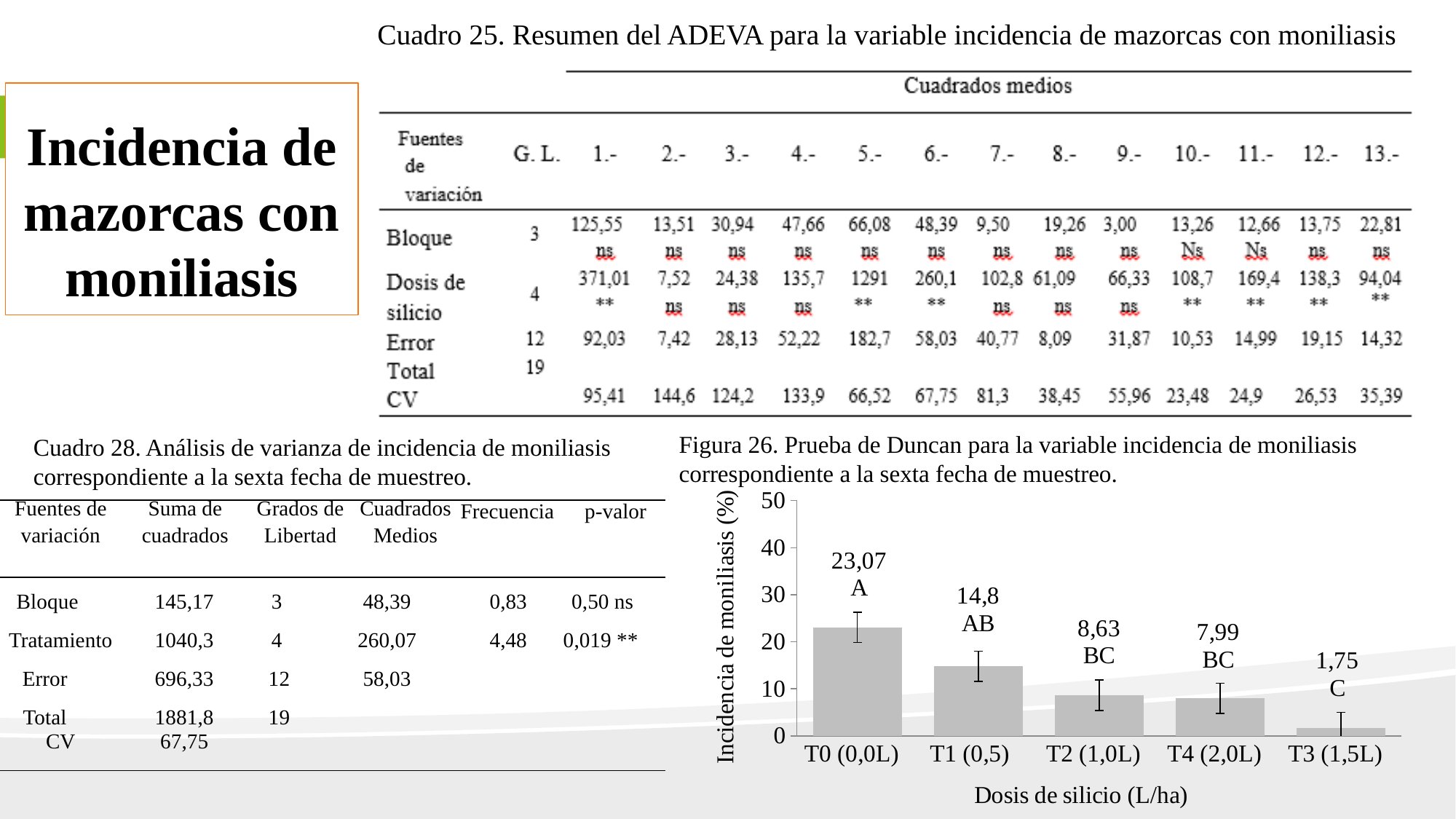
Which dose has the highest incidence of moniliasis in the Figura 26 bar chart? T0 (0,0L) In the Figura 26 bar chart, what is the difference between the values for T0 (0,0L) and T1 (0,5)? 8,27 Which dose has the lowest incidence of moniliasis in the Figura 26 bar chart? T3 (1,5L) What is the y-axis label of the Figura 26 bar chart? Incidencia de moniliasis (%) How many bars are shown in the Figura 26 bar chart? 5 In the Figura 26 bar chart, is the value for T1 (0,5) greater or less than 20? less In the Figura 26 bar chart, what is the difference between the values for T0 (0,0L) and T3 (1,5L)? 21,32 What is the value for T2 (1,0L) in the Figura 26 bar chart? 8,63 In the Figura 26 bar chart, which is larger, the value for T2 (1,0L) or T4 (2,0L)? T2 (1,0L) What kind of chart is Figura 26? bar chart What is the value for T0 (0,0L) in the Figura 26 bar chart? 23,07 What is the value for T3 (1,5L) in the Figura 26 bar chart? 1,75